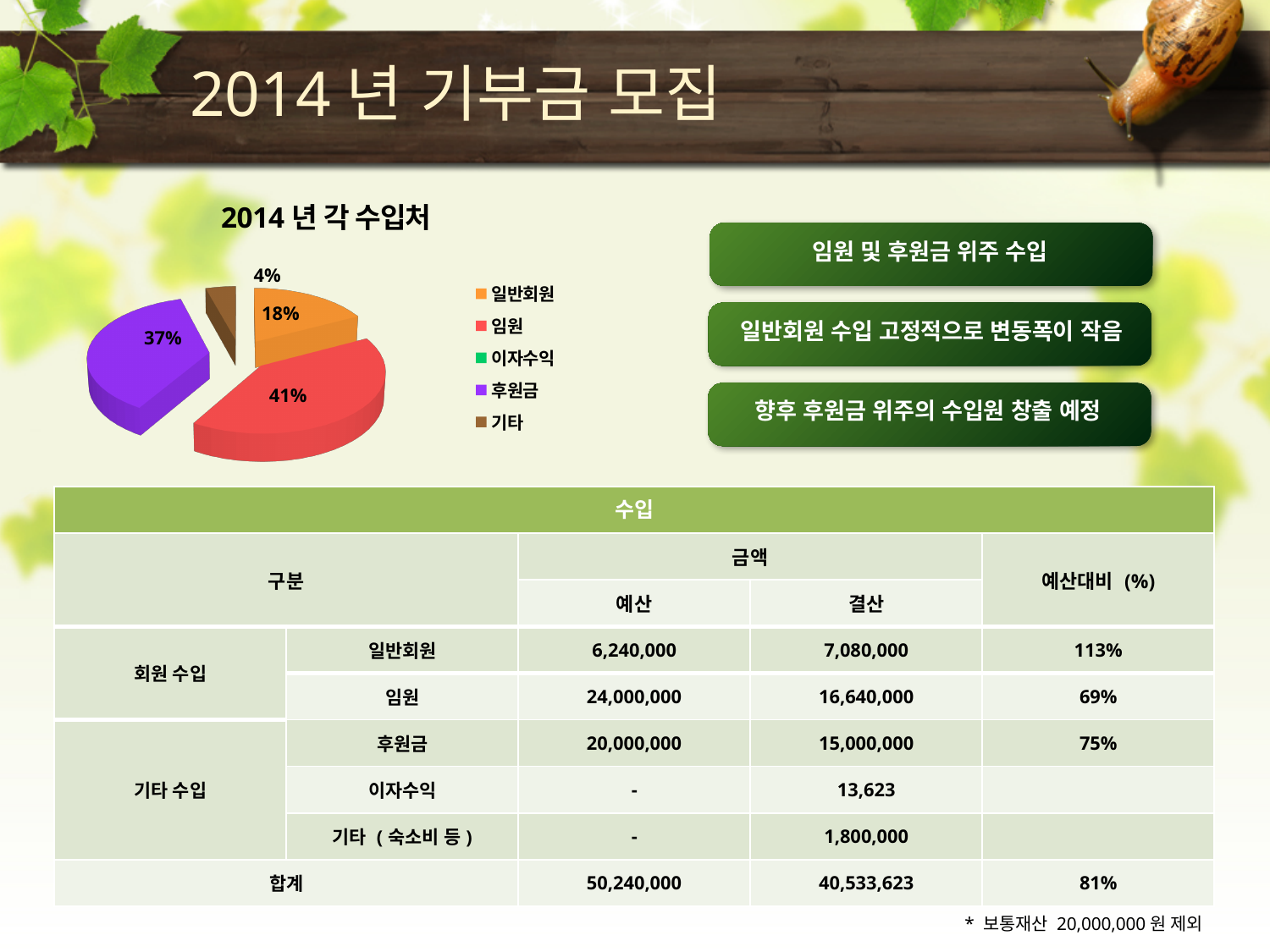
What type of chart is shown on the slide? pie chart Which is larger, the share for 임원 or the share for 후원금? 임원 How many entries does the legend of the pie chart list? 5 What percentage of the pie does 기타 account for? 4% Among the labelled slices, which category has the smallest share of the pie? 기타 Which category has the largest share of the pie? 임원 What percentage of the pie does 임원 account for? 41% What colour is the 후원금 slice in the pie chart? purple What is the title of the pie chart? 2014 년 각 수입처 What is the difference between the share for 임원 and the share for 일반회원? 23% What percentage of the pie does 후원금 account for? 37% What percentage of the pie does 일반회원 account for? 18%